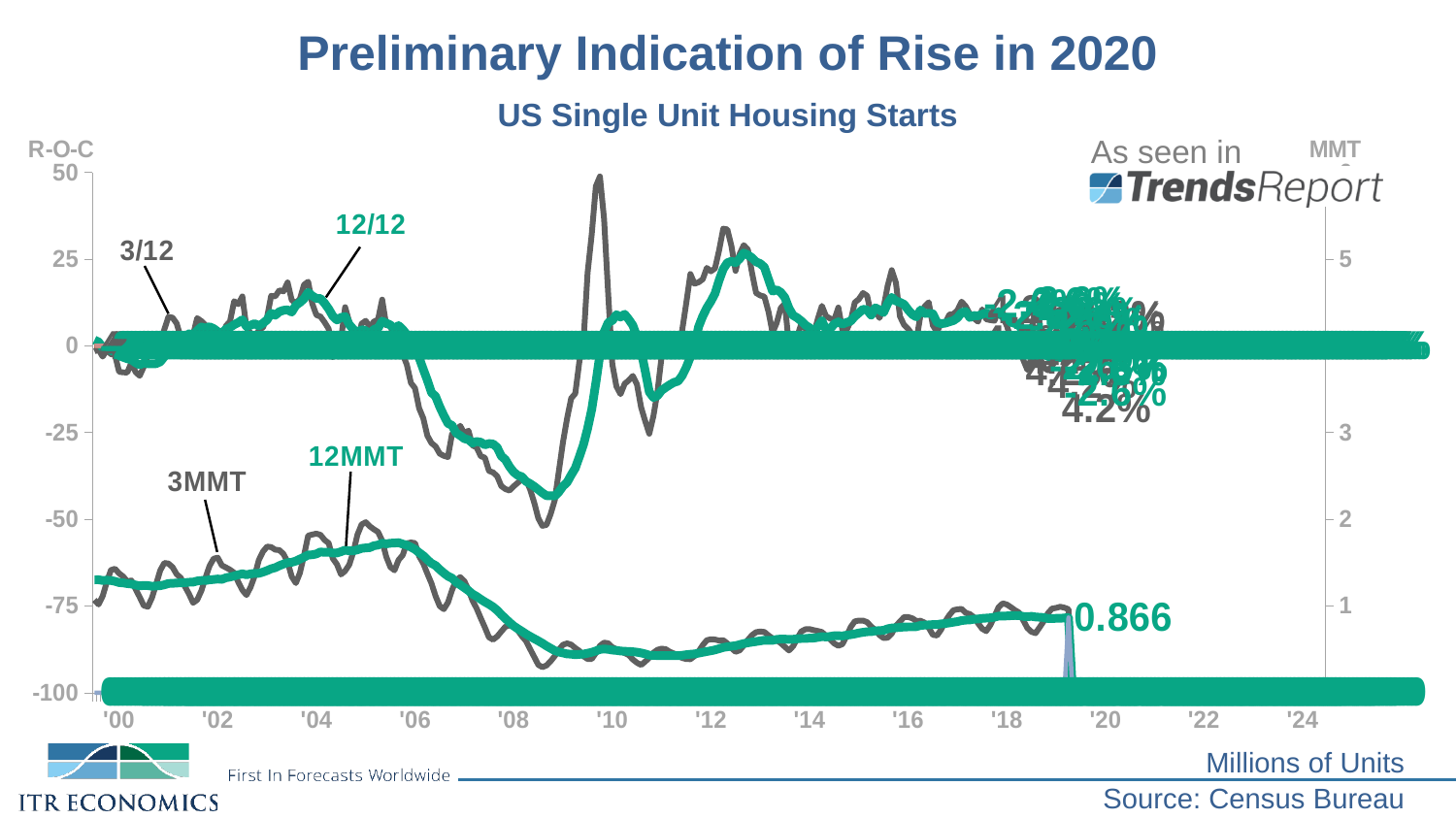
Does the 12MMT line rise or fall between '06 and '10? fall What is the first year label on the x axis? '00 What kind of chart is shown on the slide? line chart What is the highest tick value shown on the left R-O-C axis? 50 What is the source cited for the chart? Census Bureau What is the label of the left vertical axis? R-O-C Is the 12/12 value at its low point around '08-'09 greater or less than -25? less Does the 12MMT line rise or fall between '12 and '18? rise Is the 3/12 value at its peak around '09-'10 greater or less than 25? greater What is the data label printed at the end of the 12MMT line? 0.866 How many series are labeled on the chart (3/12, 12/12, 3MMT, 12MMT)? 4 What is the last year label on the x axis? '24